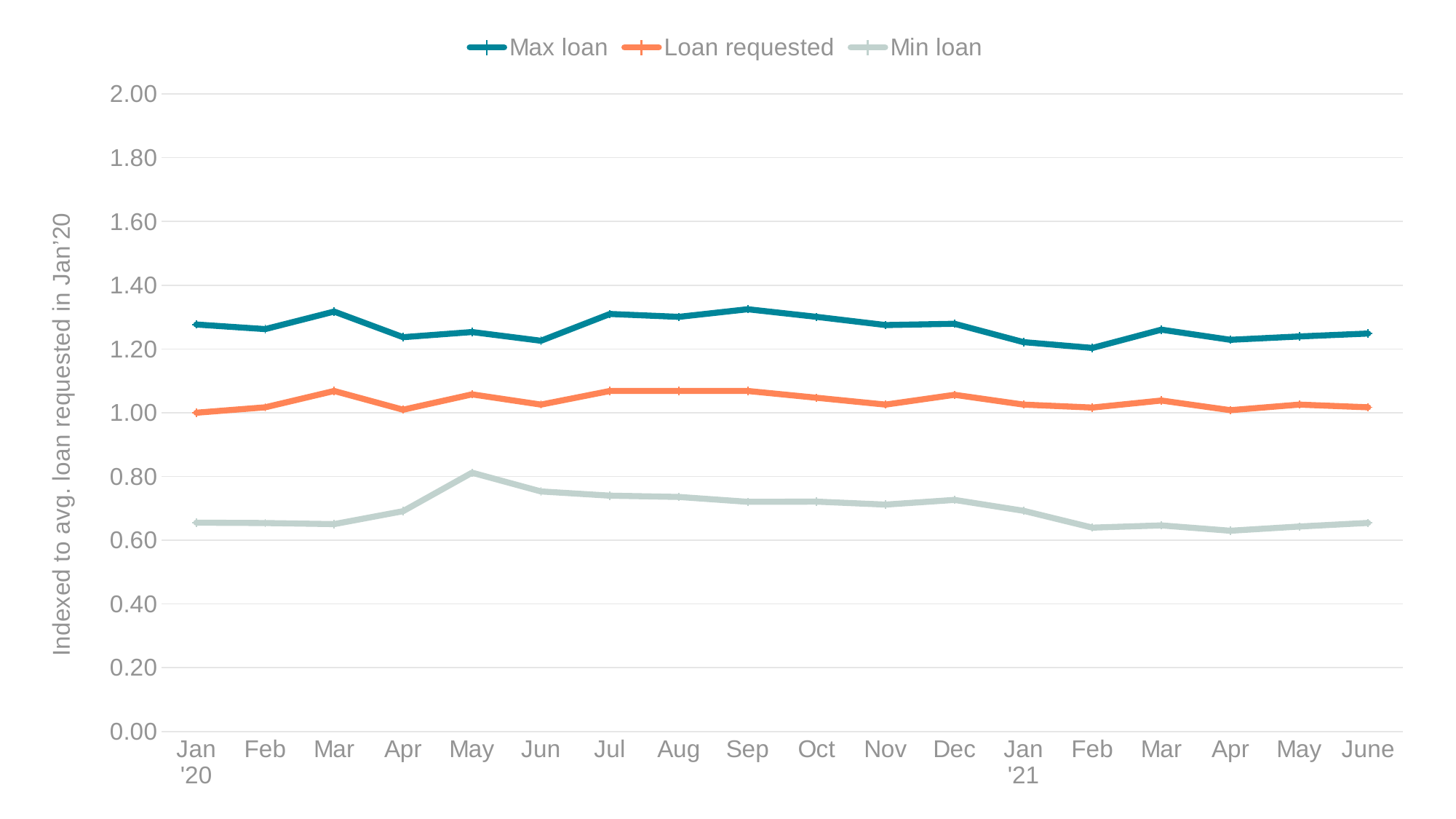
Is the value for Max loan in Jan '20 greater or less than 1.20? greater What is the title of the y axis? Indexed to avg. loan requested in Jan'20 How many series does the legend list? 3 Which is higher for Min loan: May '20 or Jan '20? May '20 What kind of chart is shown on the slide? line chart In which month does the Min loan series reach its highest value? May '20 Does the Min loan series rise or fall from Dec '20 to Feb '21? fall What is the value of Loan requested in Jan '20? 1.00 Is the value for Max loan in Sep '20 greater or less than 1.40? less Which is higher for Max loan: Mar '20 or Apr '20? Mar '20 How many months are plotted along the x axis? 18 Is the value for Min loan in Jan '21 greater or less than 0.60? greater